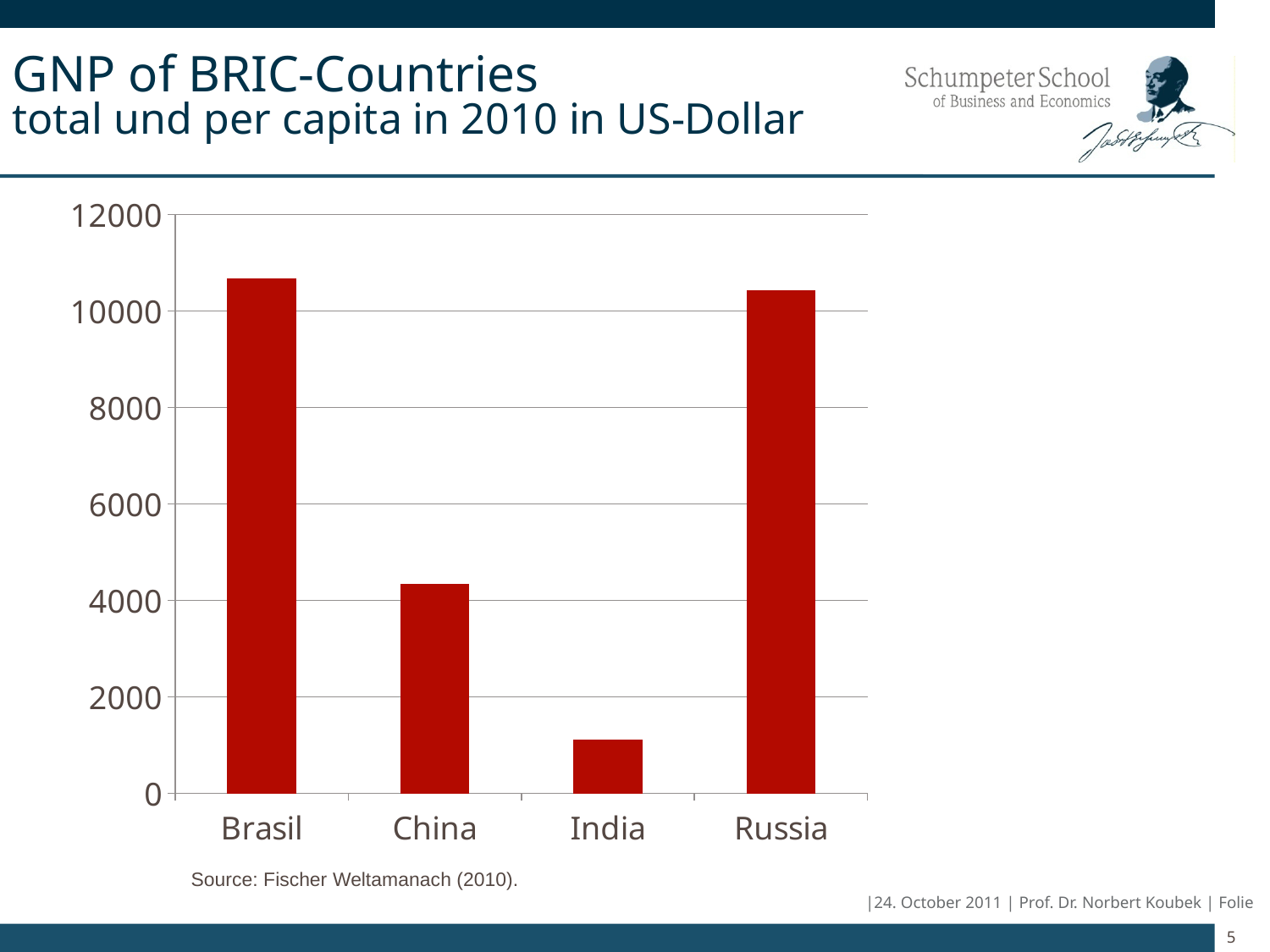
What kind of chart is shown on the slide? bar chart Is the value for Russia greater or less than 8000? greater Is the value for China greater or less than 4000? greater Is the value for China greater or less than 6000? less What colour are the bars in the chart? dark red Which has the larger value, Russia or China? Russia Which country has the lowest value in the chart? India Which has the larger value, China or India? China How many countries are shown on the x axis of the chart? 4 What is the title of the slide containing the chart? GNP of BRIC-Countries total und per capita in 2010 in US-Dollar